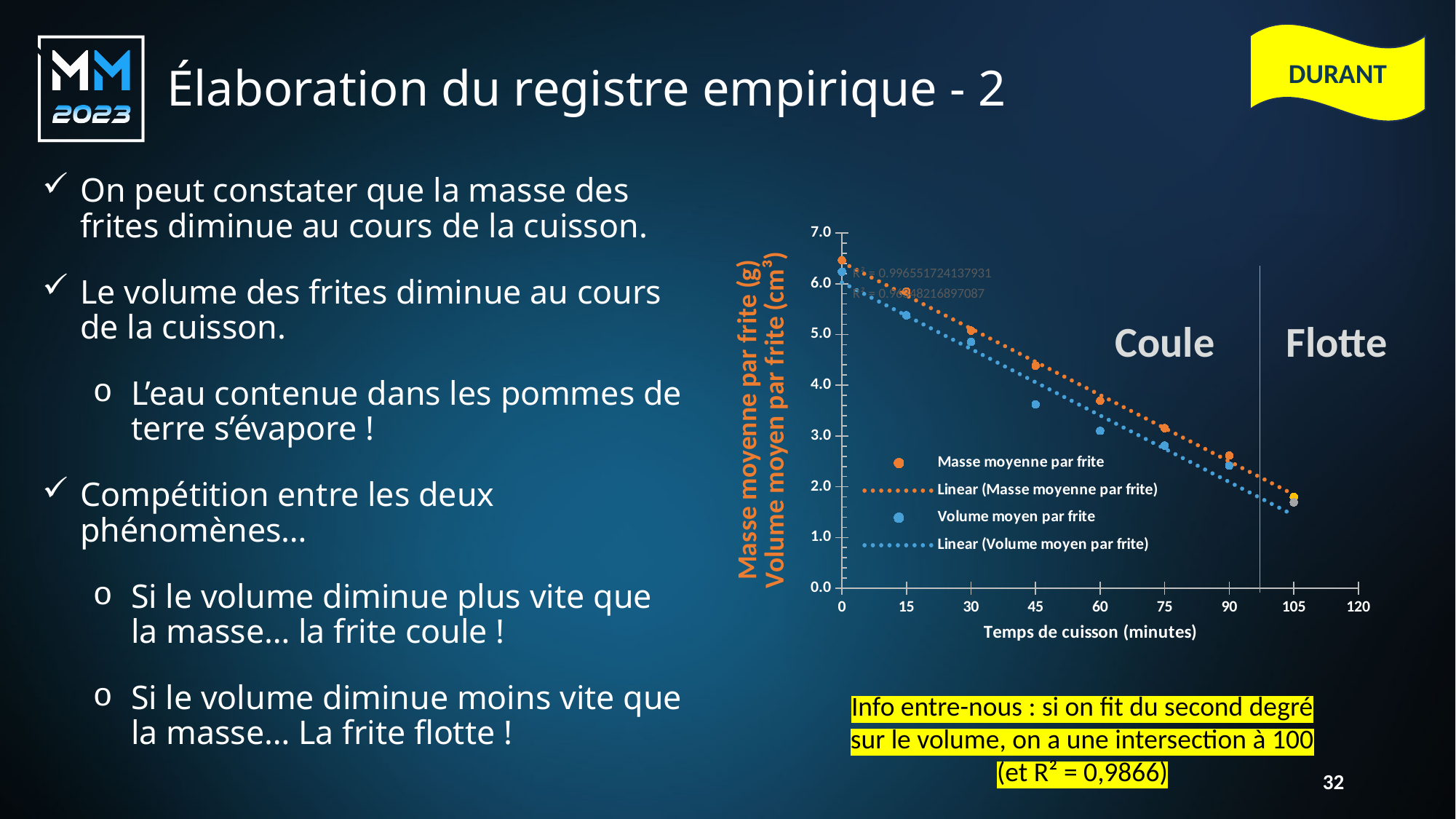
At 45 minutes, which is larger: 'Masse moyenne par frite' or 'Volume moyen par frite'? Masse moyenne par frite How many data points are plotted for the 'Masse moyenne par frite' series? 7 Which two region labels are written inside the plot area of the chart? Coule and Flotte How many entries does the chart legend list? 4 Is the 'Masse moyenne par frite' value at 0 minutes greater or less than 6.0? greater At which cooking time is the 'Masse moyenne par frite' value highest? 0 minutes What kind of chart is shown on the slide? Scatter chart Do the 'Masse moyenne par frite' values rise or fall as cooking time increases? Fall At which cooking time is the 'Volume moyen par frite' value lowest? 90 minutes What is the title of the x axis of the chart? Temps de cuisson (minutes) Is the 'Volume moyen par frite' value at 45 minutes greater or less than 4.0? less Do the 'Volume moyen par frite' values rise or fall along the x axis? Fall